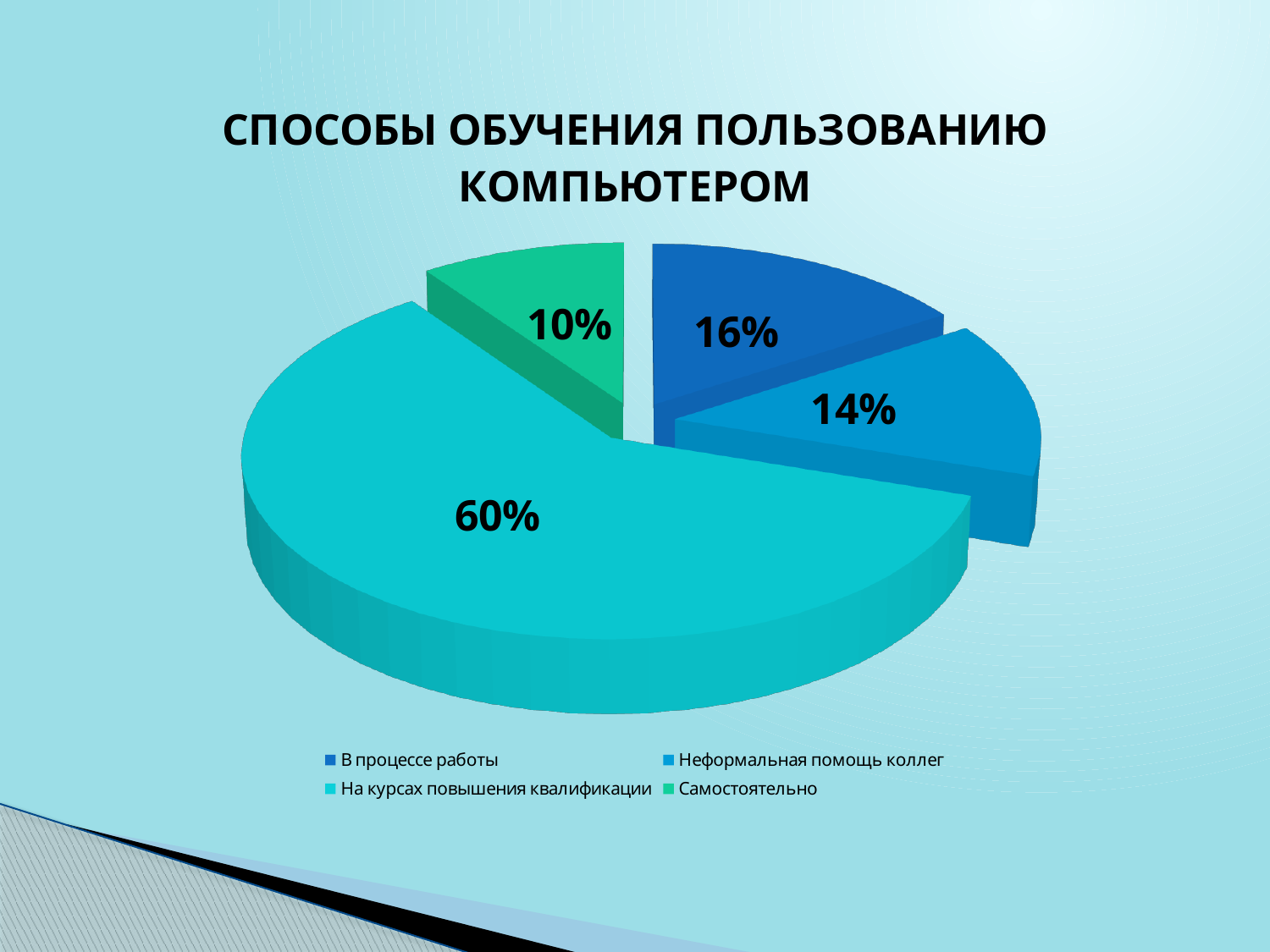
Which category is shown in green in the pie chart? Самостоятельно What is the title of the chart? СПОСОБЫ ОБУЧЕНИЯ ПОЛЬЗОВАНИЮ КОМПЬЮТЕРОМ Which is larger: the share for 'В процессе работы' or for 'Неформальная помощь коллег'? В процессе работы How many slices does the pie chart have? 4 What share of the pie is 'В процессе работы'? 16% Which category has the largest share of the pie? На курсах повышения квалификации What share of the pie is 'На курсах повышения квалификации'? 60% What kind of chart is shown on the slide? Pie chart Which category has the smallest share of the pie? Самостоятельно What is the difference between the shares of 'На курсах повышения квалификации' and 'В процессе работы'? 44% What share of the pie is 'Неформальная помощь коллег'? 14%